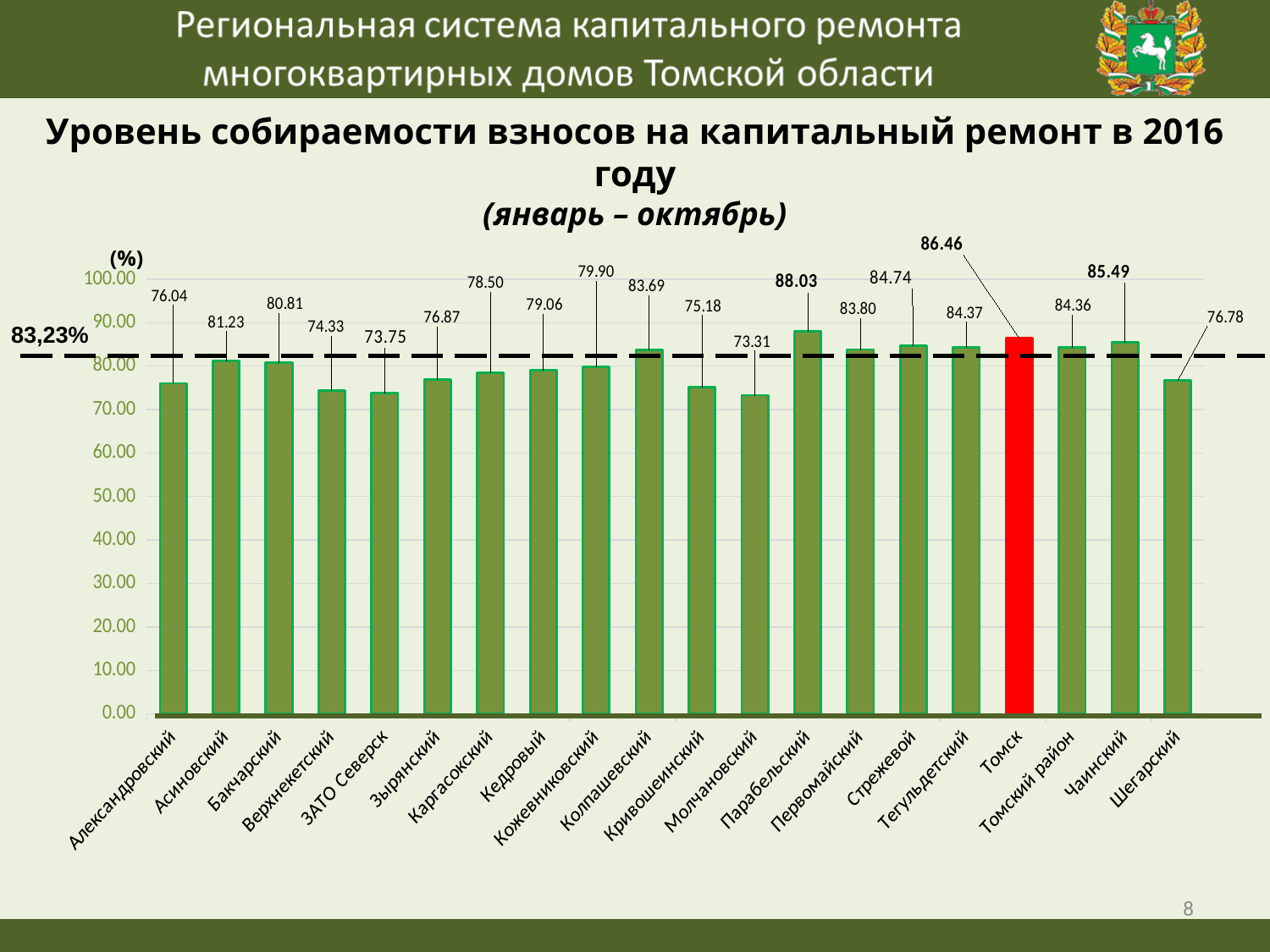
What is the value for Молчановский? 73.31 Which district has the lowest value? Молчановский What is the value for Парабельский? 88.03 How many districts (categories) are plotted on the chart? 20 What value does the dashed horizontal line on the chart mark? 83,23% What is the difference between the values for Парабельский and Молчановский? 14.72 Which district's bar is coloured red instead of green? Томск What type of chart is shown on the slide? bar chart What is the value for Шегарский? 76.78 What is the value for Томск? 86.46 Which district has the highest value? Парабельский Which has the larger value, Томск or Чаинский? Томск